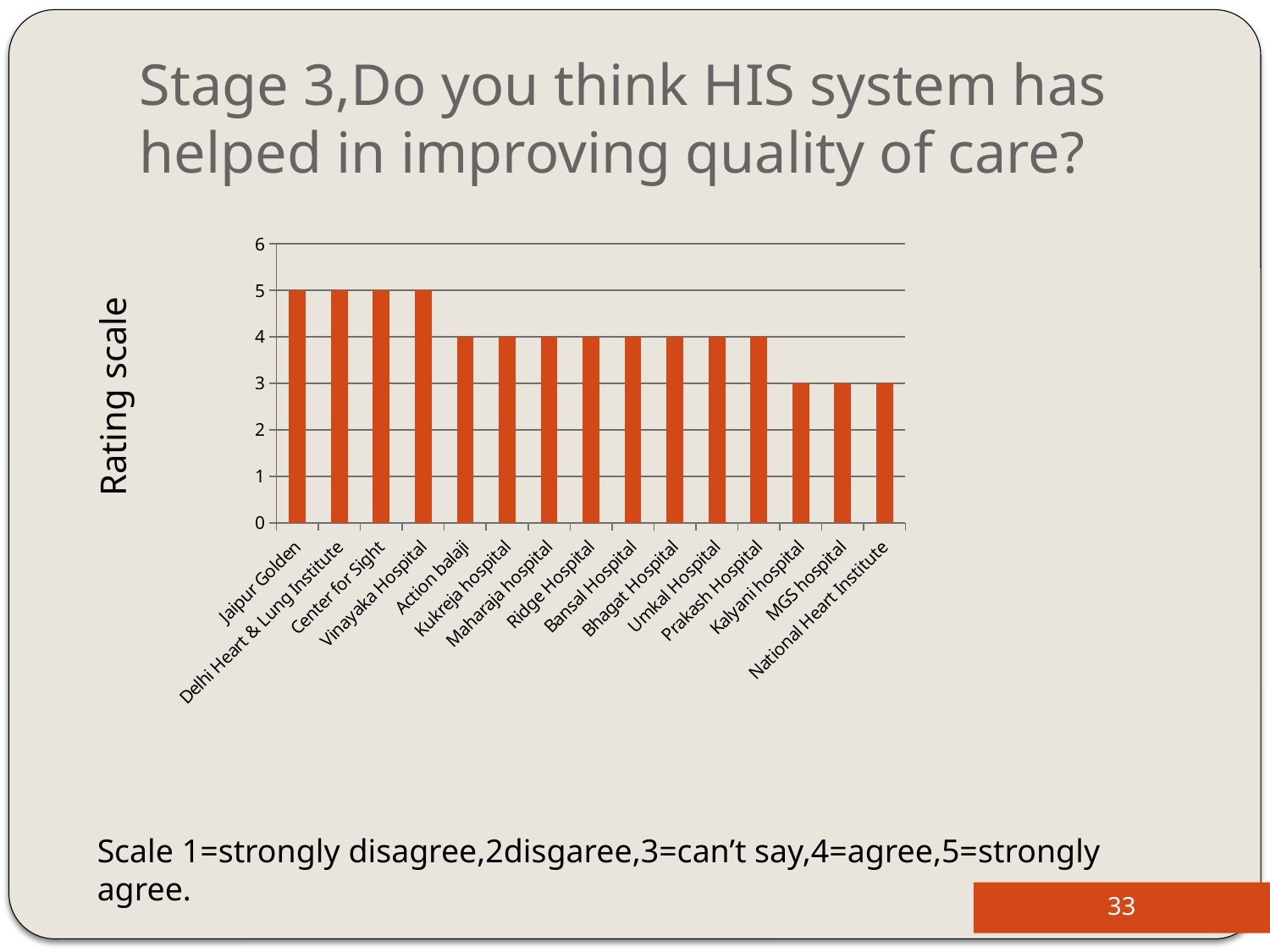
What is the difference between the rating for Jaipur Golden and the rating for Kalyani hospital? 2 Which has a higher rating, Center for Sight or MGS hospital? Center for Sight Which has a lower rating, Bansal Hospital or Delhi Heart & Lung Institute? Bansal Hospital What is the difference between the rating for Prakash Hospital and the rating for MGS hospital? 1 What kind of chart is shown on the slide? Bar chart What is the rating for Vinayaka Hospital? 5 What is the rating for Kukreja hospital? 4 How many hospitals are shown on the x axis of the chart? 15 What is the rating for National Heart Institute? 3 Do the ratings rise or fall moving from left to right along the x axis? Fall How many hospitals have a rating of 5? 4 What is the rating for Jaipur Golden? 5